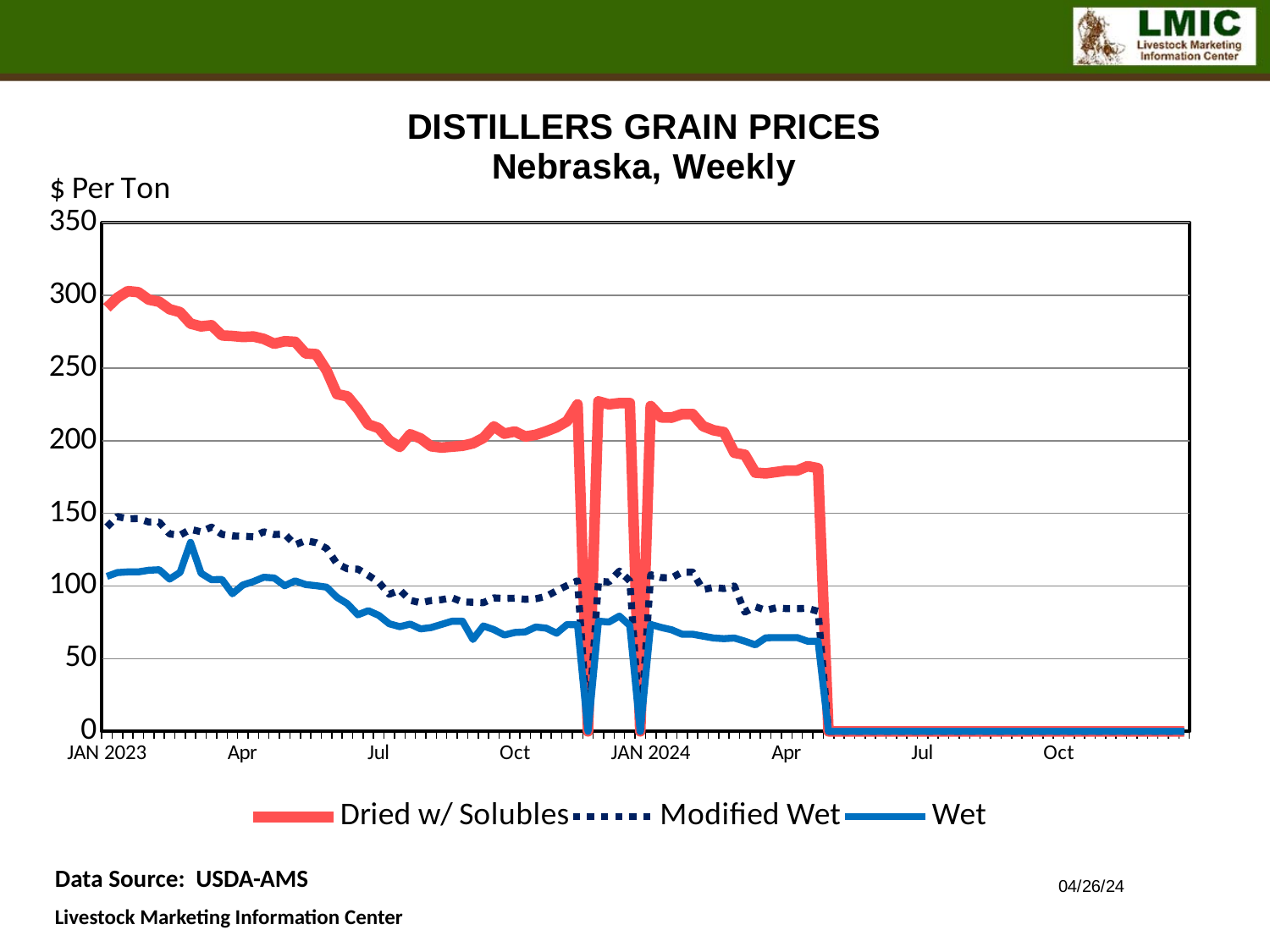
What unit is shown on the y axis of the chart? $ Per Ton Which series has the lowest prices across the plotted period? Wet What are the three series named in the legend? Dried w/ Solubles, Modified Wet, Wet Is the Modified Wet price at Jul 2023 greater or less than 150? less Which series has the highest prices across the plotted period? Dried w/ Solubles How many series does the legend list? 3 Does the Dried w/ Solubles price rise or fall from JAN 2023 to Jul 2023? Fall Is the Wet price at JAN 2023 greater or less than 150? less At JAN 2023, which is larger: the Dried w/ Solubles price or the Wet price? Dried w/ Solubles Is the Dried w/ Solubles price at Oct 2023 greater or less than 250? less What kind of chart is shown on the slide? Line chart